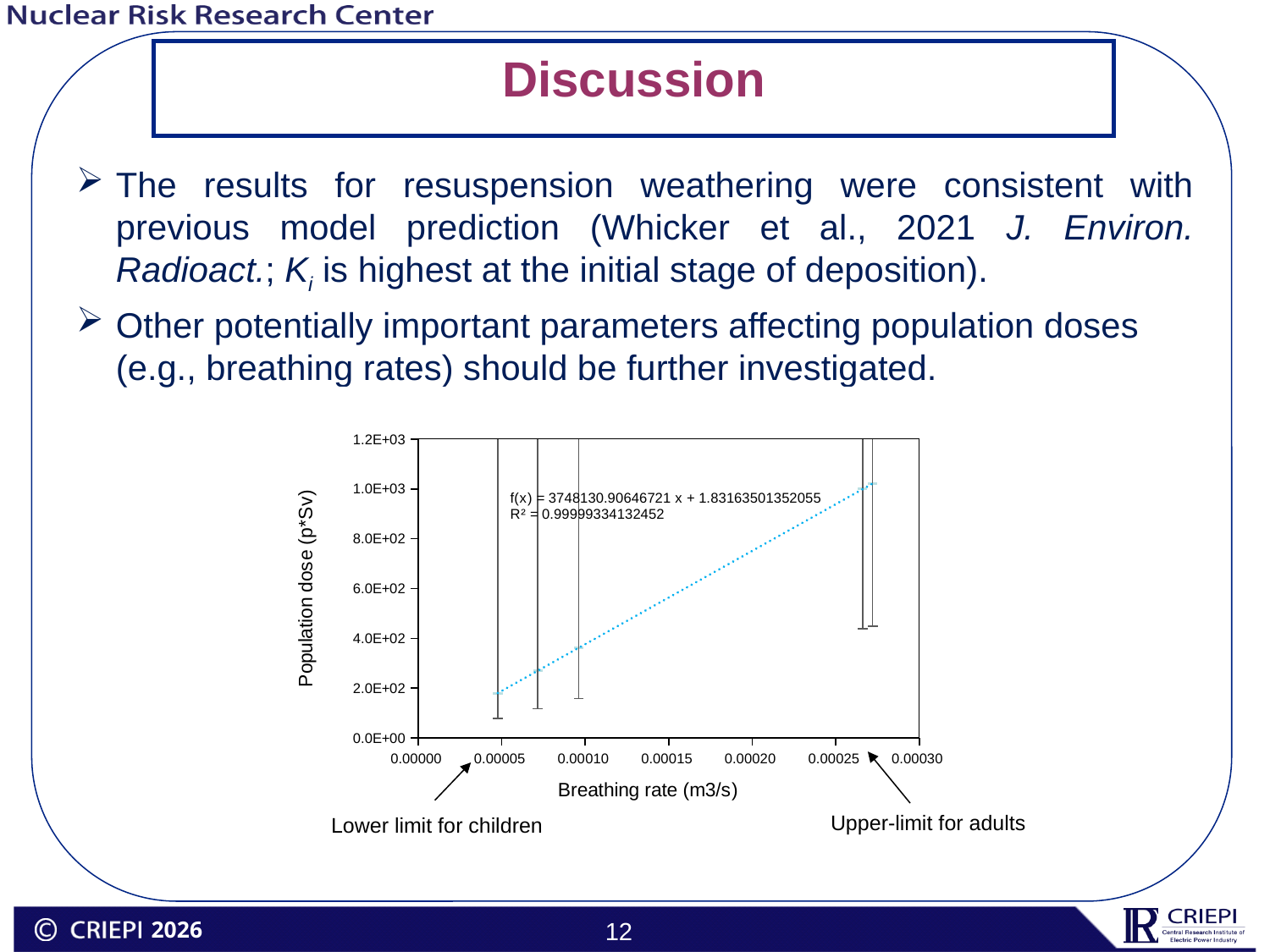
What is the intercept of the fitted line f(x) printed on the chart? 1.83163501352055 What is the title of the y axis of the chart? Population dose (p*Sv) Is the population dose for the point at a breathing rate of about 0.00010 m3/s greater or less than 4.0E+02? less What is the highest value shown on the y axis of the chart? 1.2E+03 Does the population dose rise or fall as the breathing rate increases along the x axis? Rises Is the population dose for the point at the highest breathing rate (about 0.00028 m3/s) greater or less than 8.0E+02? greater Is the population dose for the point at a breathing rate of about 0.00005 m3/s greater or less than 4.0E+02? less What is the slope of the fitted line f(x) printed on the chart? 3748130.90646721 What kind of chart is shown on the slide? Scatter chart Which point has the higher population dose: the one at a breathing rate of about 0.00005 m3/s or the one at about 0.00028 m3/s? The one at about 0.00028 m3/s What R² value is printed for the trendline on the chart? 0.99999334132452 What is the title of the x axis of the chart? Breathing rate (m3/s)